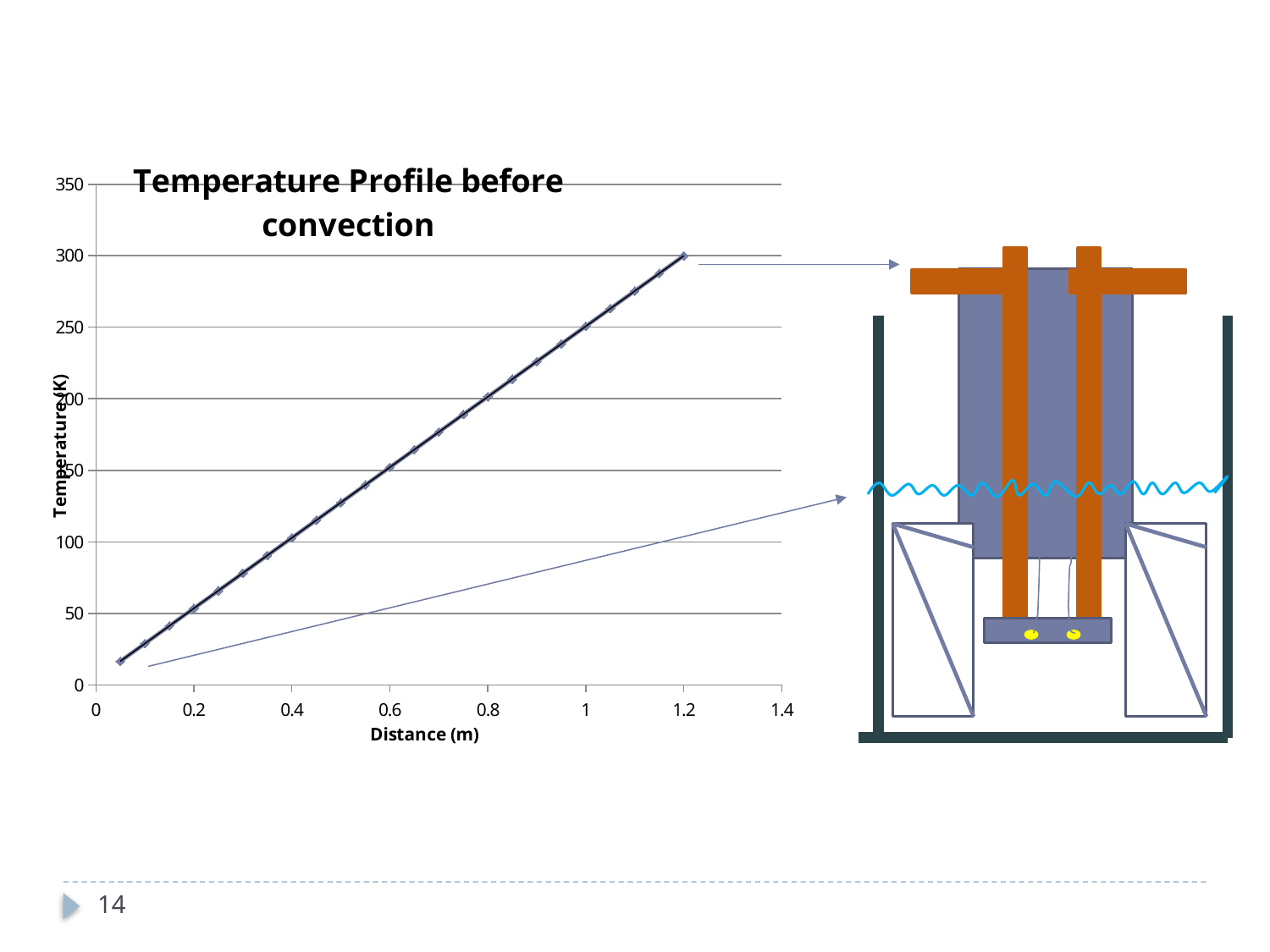
What kind of chart is shown on the slide? line chart At which distance is the temperature highest? 1.2 m What is the temperature at a distance of 1.2 m? 300 Is the temperature at the smallest plotted distance greater or less than 50? less What is the title of the chart? Temperature Profile before convection Is the temperature at a distance of 1.2 m greater or less than 250? greater Is the temperature at a distance of 1 m greater or less than 200? greater What is the label of the x axis of the chart? Distance (m) Which is larger, the temperature at 0.4 m or the temperature at 1 m? 1 m Do the temperature values rise or fall as distance increases along the x axis? rise